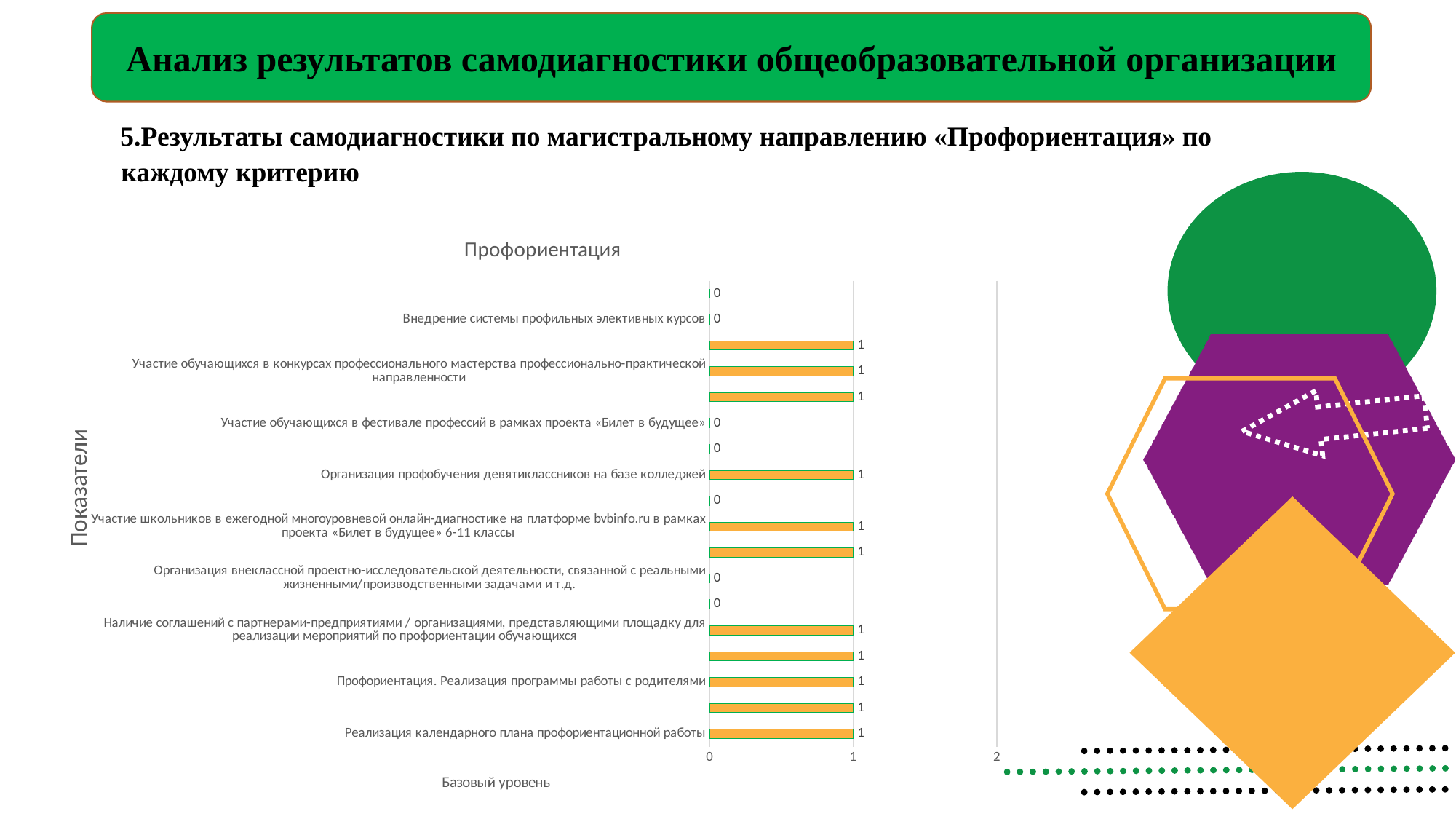
What is the highest value shown by any bar in the chart? 1 How many bars are plotted in the chart? 18 What is the value for "Реализация календарного плана профориентационной работы"? 1 What kind of chart is shown on the slide? bar chart Which is larger: the value for "Организация профобучения девятиклассников на базе колледжей" or the value for "Внедрение системы профильных элективных курсов"? Организация профобучения девятиклассников на базе колледжей What is the title of the chart? Профориентация What is the value for "Внедрение системы профильных элективных курсов"? 0 What is the value for "Участие обучающихся в фестивале профессий в рамках проекта «Билет в будущее»"? 0 What is the value for "Профориентация. Реализация программы работы с родителями"? 1 What is the value for "Организация профобучения девятиклассников на базе колледжей"? 1 What is the title of the horizontal axis of the chart? Базовый уровень What is the difference between the value for "Реализация календарного плана профориентационной работы" and the value for "Участие обучающихся в фестивале профессий в рамках проекта «Билет в будущее»"? 1